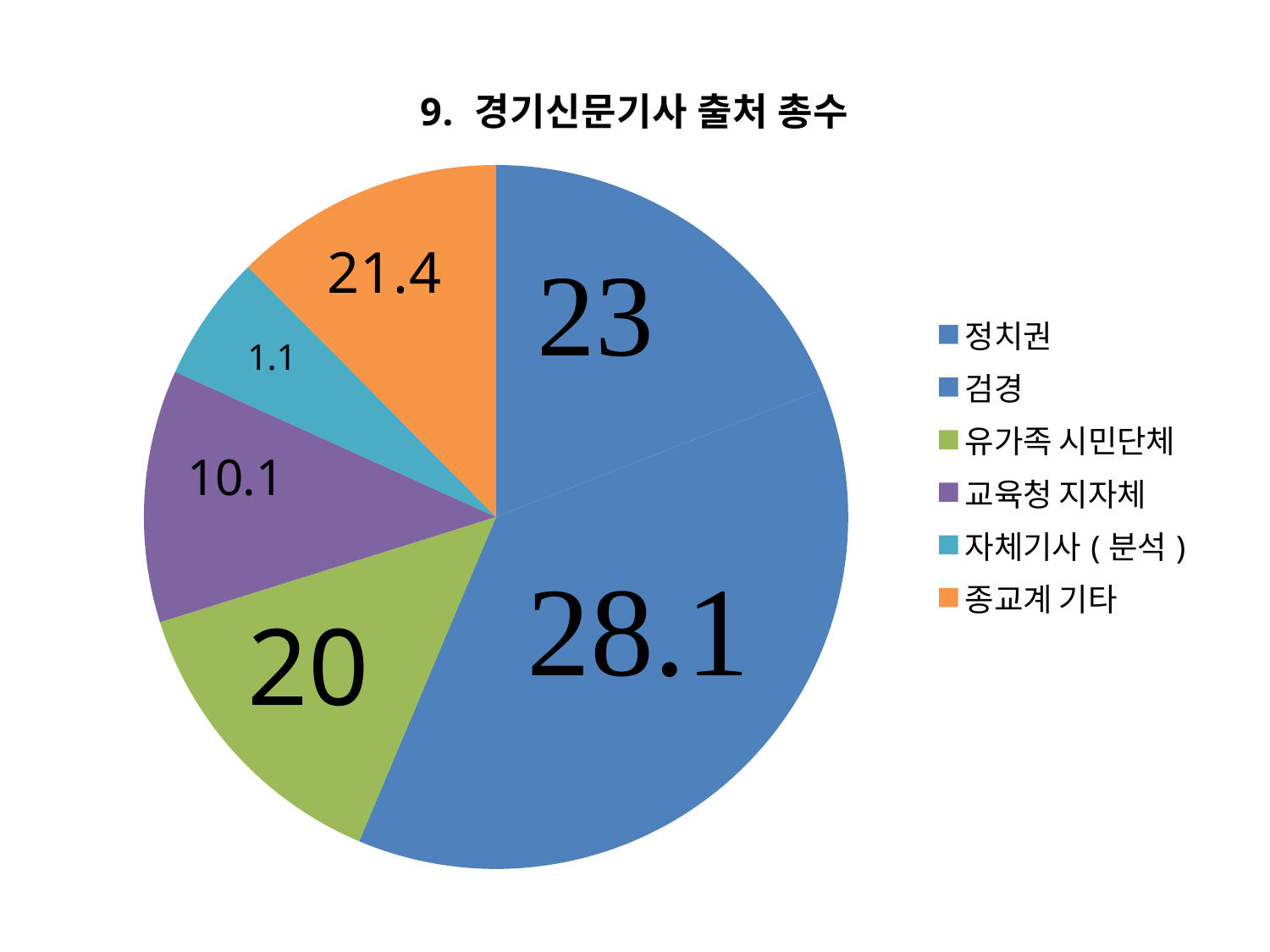
Which category has the smallest slice? 자체기사 ( 분석 ) What is the value for 유가족 시민단체? 20 What is the value for 정치권? 23 Which category has the largest slice? 검경 What is the difference between the values for 검경 and 정치권? 5.1 What is the value for 종교계 기타? 21.4 How many categories does the legend list? 6 What is the value for 검경? 28.1 Which is larger, the value for 종교계 기타 or the value for 유가족 시민단체? 종교계 기타 What is the value for 자체기사 ( 분석 )? 1.1 What is the value for 교육청 지자체? 10.1 What type of chart is shown on the slide? pie chart